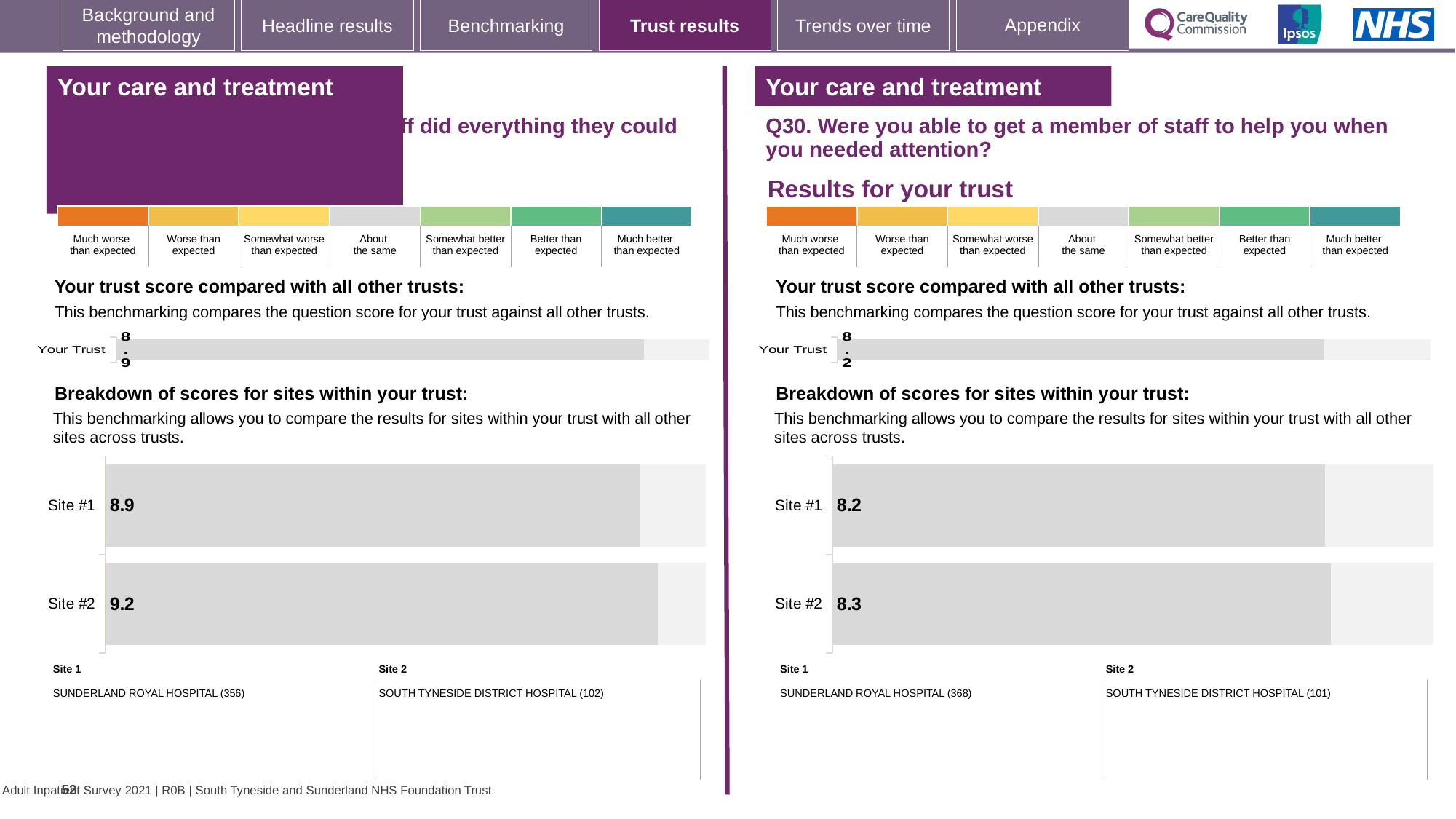
On the left-hand slide, what is the score for Site #1 in the breakdown of scores for sites within your trust? 8.9 How many sites are shown in the breakdown of scores for sites chart on the right-hand slide (Q30)? 2 On the left-hand slide, what is the score for Site #2 in the breakdown of scores for sites within your trust? 9.2 On the right-hand slide (Q30), what is the 'Your Trust' score in the chart comparing your trust score with all other trusts? 8.2 On the left-hand slide's breakdown of scores for sites chart, what is the difference between the Site #2 and Site #1 scores? 0.3 What type of chart is used for the breakdown of scores for sites within your trust on the left-hand slide? Bar chart On the right-hand slide (Q30), what is the score for Site #1 in the breakdown of scores for sites within your trust? 8.2 On the right-hand slide's (Q30) breakdown of scores for sites chart, what is the difference between the Site #2 and Site #1 scores? 0.1 On the left-hand slide's breakdown of scores for sites chart, which site has the higher score? Site #2 On the right-hand slide's (Q30) breakdown of scores for sites chart, which site has the lower score? Site #1 On the right-hand slide (Q30), what is the score for Site #2 in the breakdown of scores for sites within your trust? 8.3 On the left-hand slide, what is the 'Your Trust' score in the chart comparing your trust score with all other trusts? 8.9